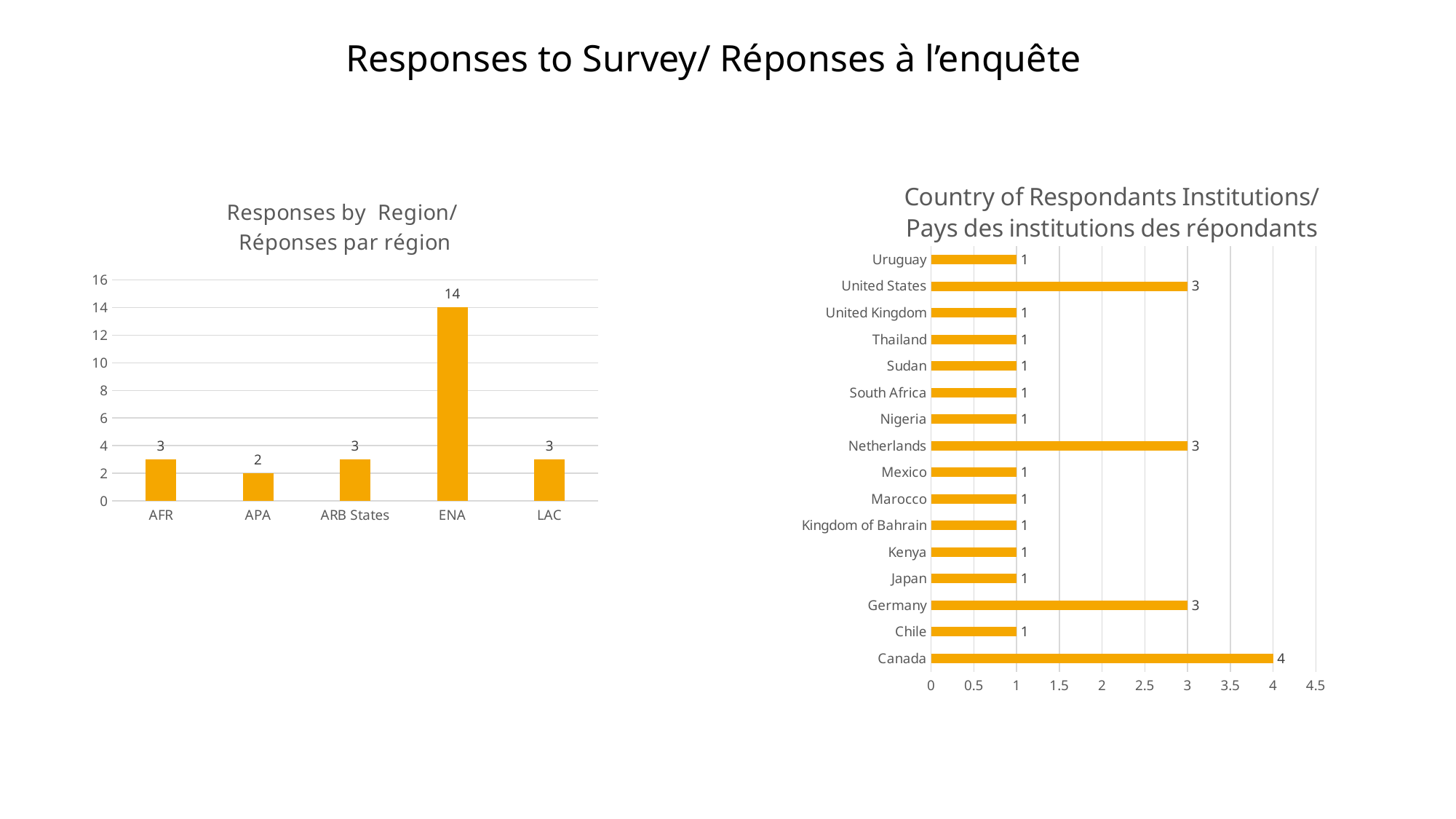
In the 'Country of Respondants Institutions' chart, which country has the highest value? Canada In the 'Country of Respondants Institutions' chart, how many countries are listed? 16 In the 'Country of Respondants Institutions' chart, what is the value for Canada? 4 In the 'Country of Respondants Institutions' chart, what is the value for Netherlands? 3 In the 'Responses by Region' chart, which region has the highest value? ENA In the 'Responses by Region' chart, what is the value for ENA? 14 In the 'Responses by Region' chart, what is the difference between the values for ENA and AFR? 11 What type of chart is the 'Country of Respondants Institutions' chart? Bar chart In the 'Responses by Region' chart, how many regions are shown? 5 In the 'Responses by Region' chart, which region has the lowest value? APA In the 'Country of Respondants Institutions' chart, is the value for Germany larger than the value for Japan? Yes In the 'Responses by Region' chart, what is the value for APA? 2